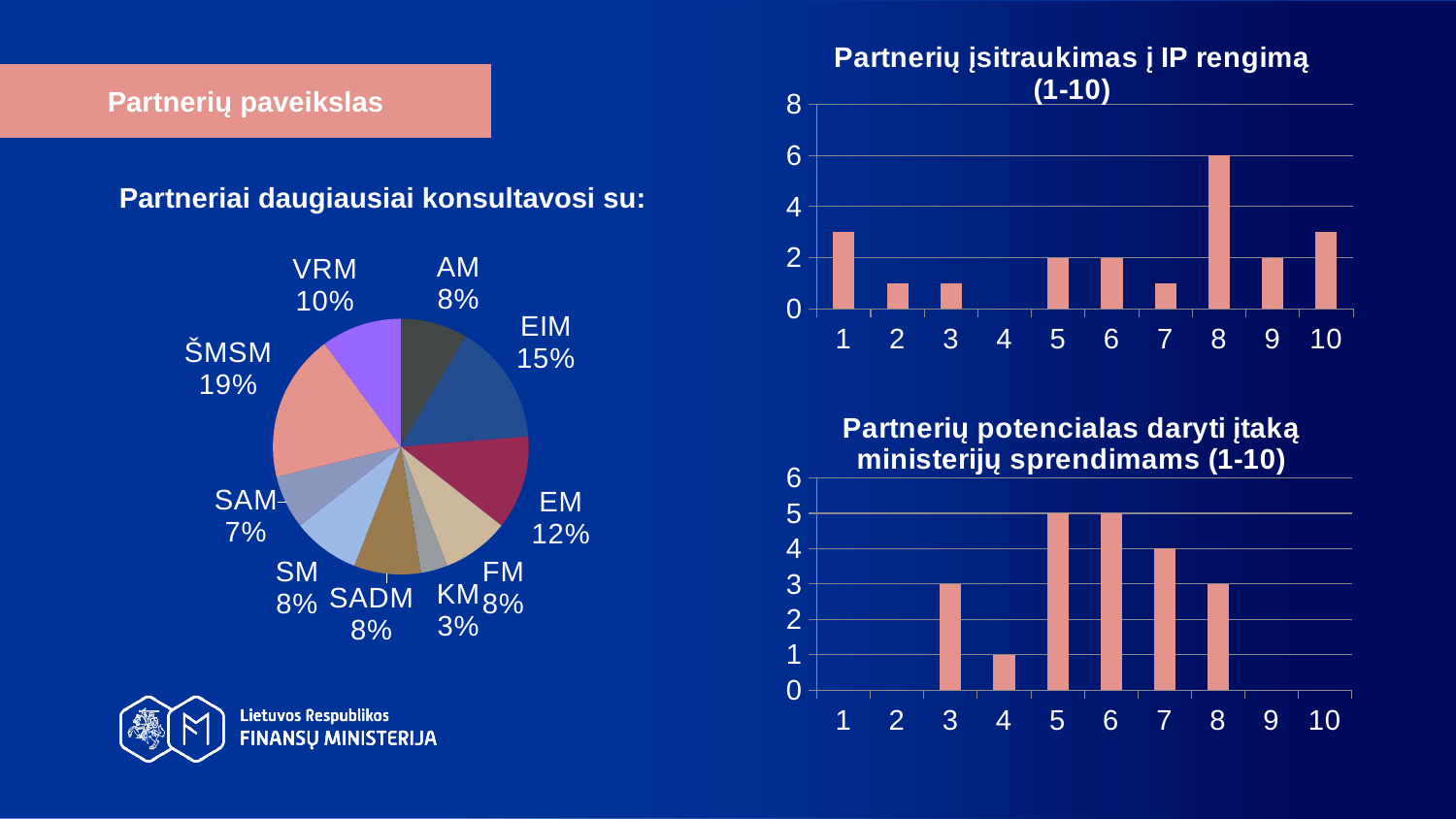
In the chart 'Partnerių įsitraukimas į IP rengimą (1-10)', which category has the highest value? 8 What kind of chart is 'Partnerių potencialas daryti įtaką ministerijų sprendimams (1-10)'? bar chart In the pie chart 'Partneriai daugiausiai konsultavosi su:', what share does ŠMSM have? 19% In the pie chart 'Partneriai daugiausiai konsultavosi su:', which is larger, VRM or SAM? VRM In the pie chart 'Partneriai daugiausiai konsultavosi su:', which category has the largest share? ŠMSM In the pie chart 'Partneriai daugiausiai konsultavosi su:', what is the difference between the EIM share and the EM share? 3% In the chart 'Partnerių įsitraukimas į IP rengimą (1-10)', what is the value for category 8? 6 In the chart 'Partnerių potencialas daryti įtaką ministerijų sprendimams (1-10)', what is the value for category 7? 4 In the chart 'Partnerių įsitraukimas į IP rengimą (1-10)', is the value for category 1 greater or less than 2? greater In the pie chart 'Partneriai daugiausiai konsultavosi su:', how many categories are shown? 10 In the pie chart 'Partneriai daugiausiai konsultavosi su:', which category has the smallest share? KM In the chart 'Partnerių potencialas daryti įtaką ministerijų sprendimams (1-10)', what is the difference between the values for category 5 and category 4? 4